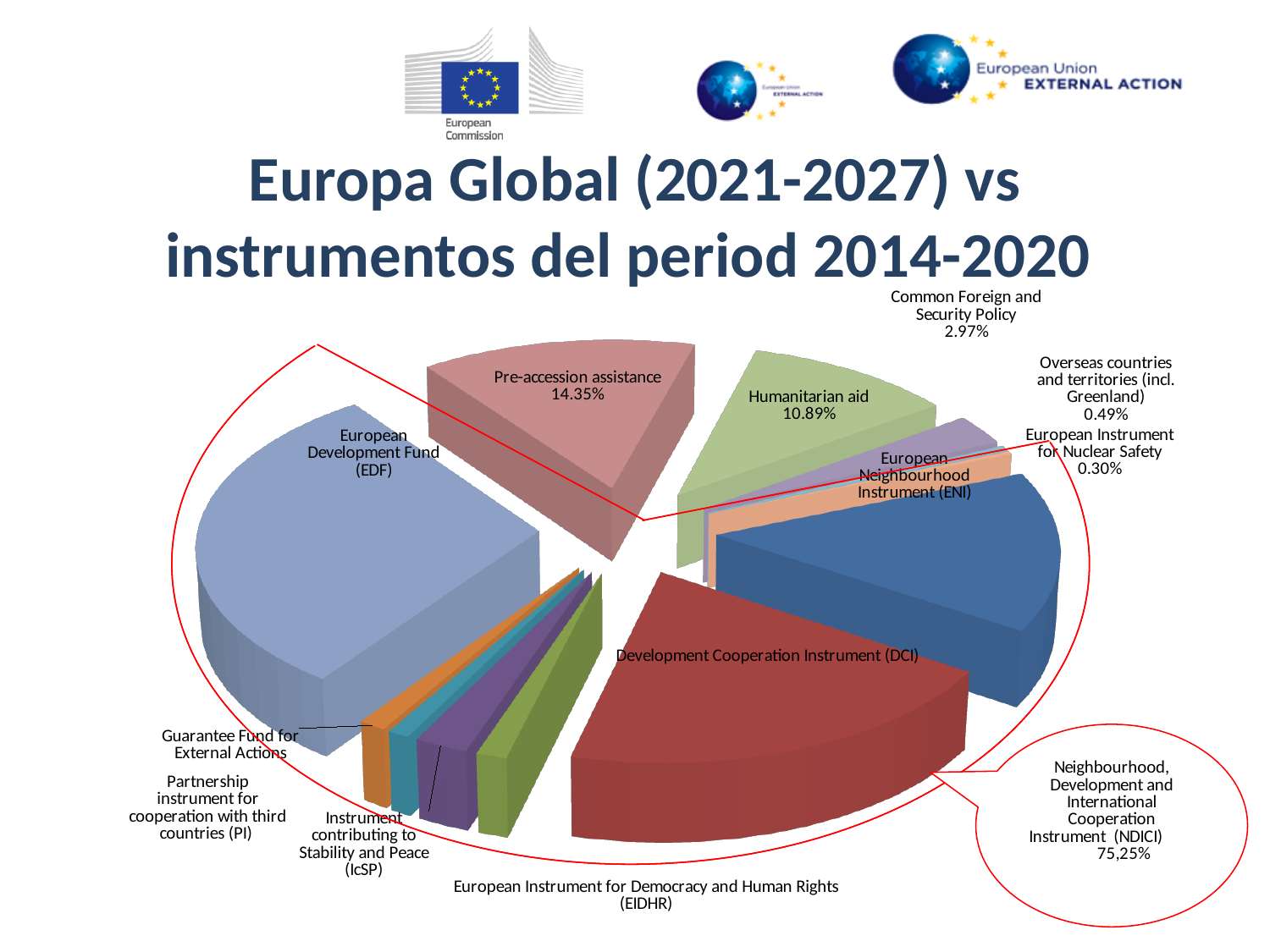
What is the title of the slide containing the pie chart? Europa Global (2021-2027) vs instrumentos del period 2014-2020 Which is larger, the share for Pre-accession assistance or the share for Humanitarian aid? Pre-accession assistance What is the difference between the Common Foreign and Security Policy share and the Overseas countries and territories share? 2.48% By how many percentage points does Pre-accession assistance exceed Humanitarian aid? 3.46% What share of the pie is labelled for Pre-accession assistance? 14.35% What percentage is shown for the European Instrument for Nuclear Safety? 0.30% What percentage is shown for Overseas countries and territories (incl. Greenland)? 0.49% What percentage is shown for Humanitarian aid? 10.89% What kind of chart is shown on the slide? pie chart What percentage is shown for Common Foreign and Security Policy? 2.97% What percentage is given in the annotation for the Neighbourhood, Development and International Cooperation Instrument (NDICI)? 75,25% Which is larger, the share for Overseas countries and territories or the share for the European Instrument for Nuclear Safety? Overseas countries and territories